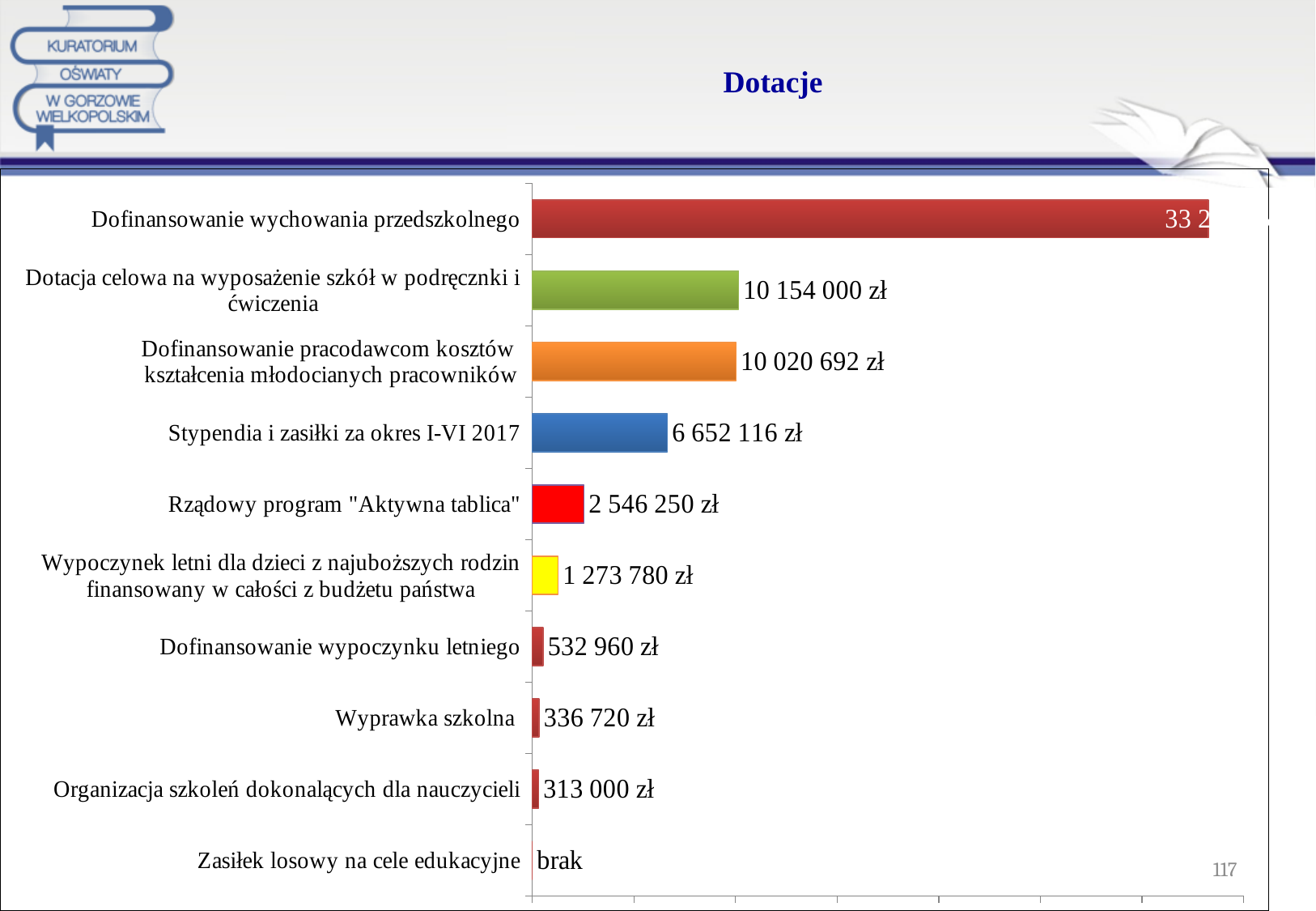
What is the difference between "Dofinansowanie wypoczynku letniego" and "Wyprawka szkolna"? 196 240 zł What is the value for "Wyprawka szkolna"? 336 720 zł What is the value for "Stypendia i zasiłki za okres I-VI 2017"? 6 652 116 zł What kind of chart is shown on the slide? Bar chart Among the categories with a bar, which has the lowest value? Organizacja szkoleń dokonalących dla nauczycieli How many categories are listed on the chart? 10 What is the value for "Dotacja celowa na wyposażenie szkół w podręczniki i ćwiczenia"? 10 154 000 zł Which is larger: "Stypendia i zasiłki za okres I-VI 2017" or "Rządowy program "Aktywna tablica""? Stypendia i zasiłki za okres I-VI 2017 What is the value for "Rządowy program "Aktywna tablica""? 2 546 250 zł What is shown for "Zasiłek losowy na cele edukacyjne"? brak What is the difference between "Dotacja celowa na wyposażenie szkół w podręczniki i ćwiczenia" and "Dofinansowanie pracodawcom kosztów kształcenia młodocianych pracowników"? 133 308 zł Which category has the highest value? Dofinansowanie wychowania przedszkolnego